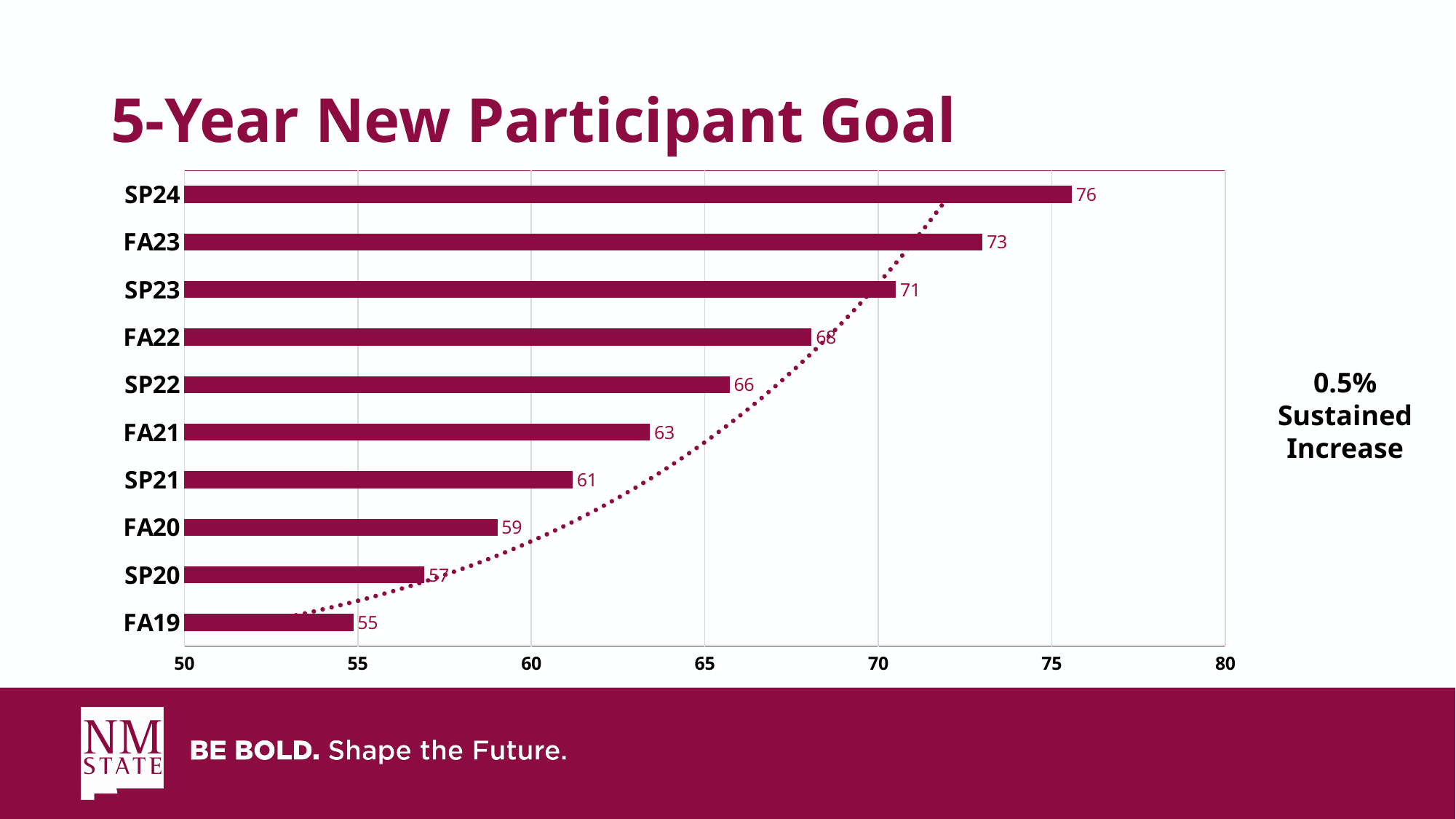
How many categories are shown on the chart? 10 What is the value for SP22? 66 What is the difference between the values for SP24 and FA19? 21 What is the value for FA21? 63 What is the title of the chart? 5-Year New Participant Goal Which category has the highest value? SP24 What is the value for FA19? 55 Which is larger, the value for FA22 or the value for SP21? FA22 Which category has the lowest value? FA19 What kind of chart is shown on the slide? bar chart What is the value for SP24? 76 Is the value for SP23 greater or less than 70? greater